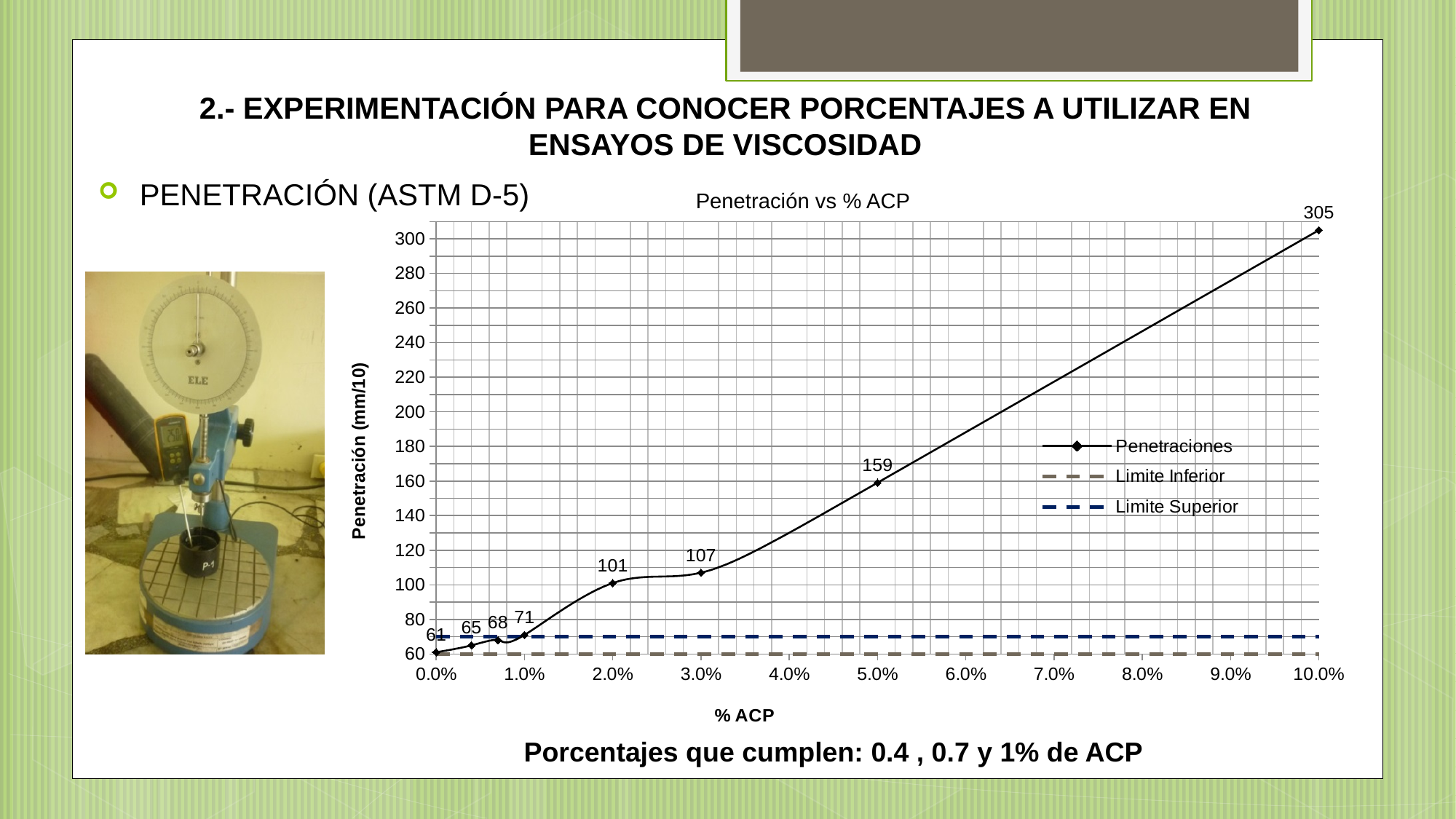
What is the penetration value at 10.0% ACP? 305 What is the penetration value at 0.0% ACP? 61 How many data points are plotted on the Penetraciones series? 8 Do the penetration values rise or fall as % ACP increases? rise At which % ACP is the penetration highest? 10.0% At which % ACP is the penetration lowest? 0.0% How many series does the legend list? 3 What is the penetration value at 2.0% ACP? 101 What kind of chart is shown? line chart What is the penetration value at 5.0% ACP? 159 Which is larger, the penetration at 3.0% ACP or at 2.0% ACP? 3.0% ACP What is the difference between the penetration at 10.0% ACP and at 5.0% ACP? 146